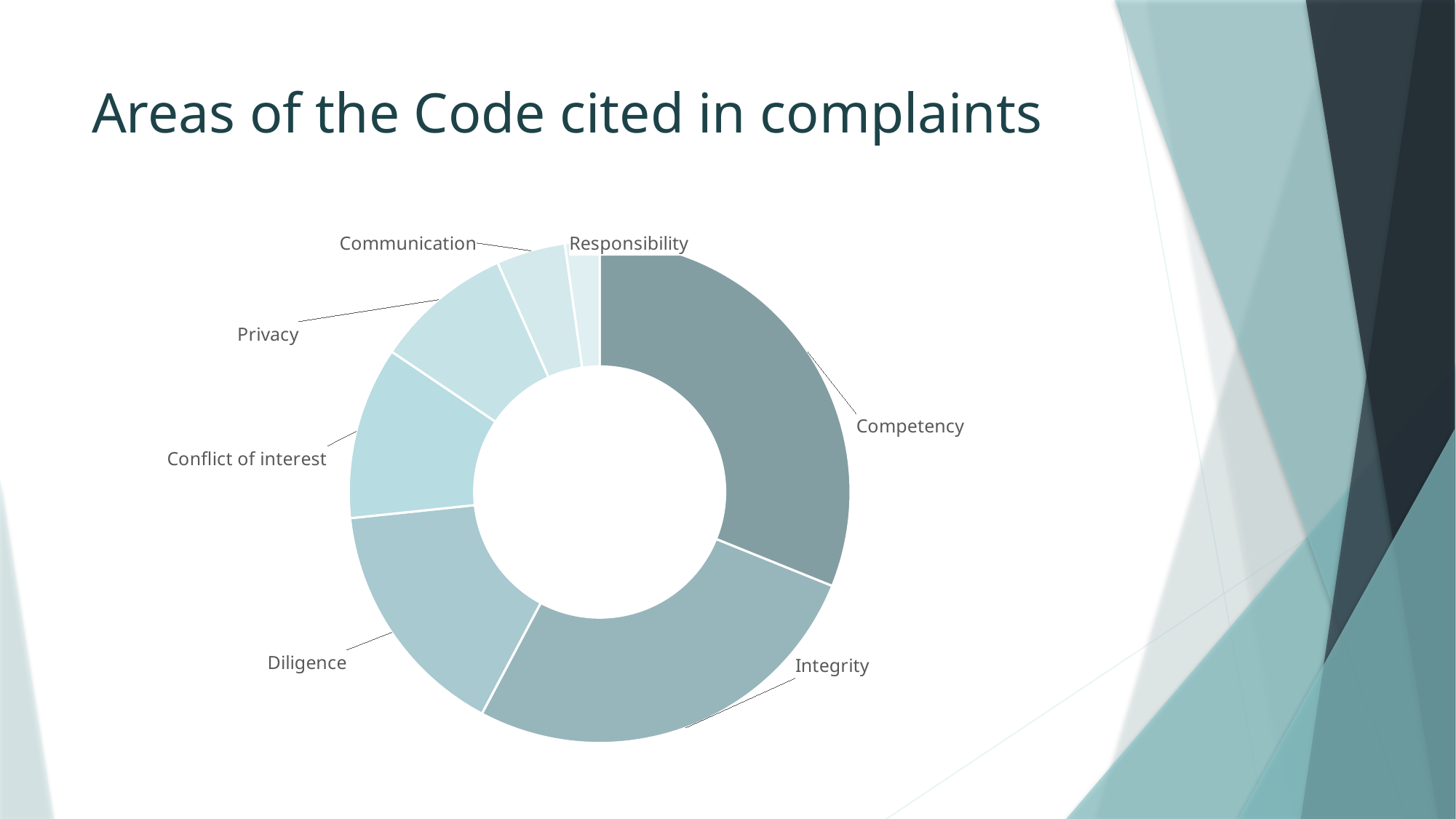
Which area of the Code has the largest slice in the chart? Competency Which area of the Code has the second-largest slice in the chart? Integrity Which slice is larger, Competency or Integrity? Competency What kind of chart is shown on the slide? Doughnut chart What is the title of the chart on the slide? Areas of the Code cited in complaints Which slice is larger, Diligence or Conflict of interest? Diligence How many areas of the Code are shown as slices in the chart? 7 Which slice is larger, Integrity or Diligence? Integrity Which area of the Code has the smallest slice in the chart? Responsibility Which slice is labelled directly to the right of the chart, next to the darkest segment? Competency